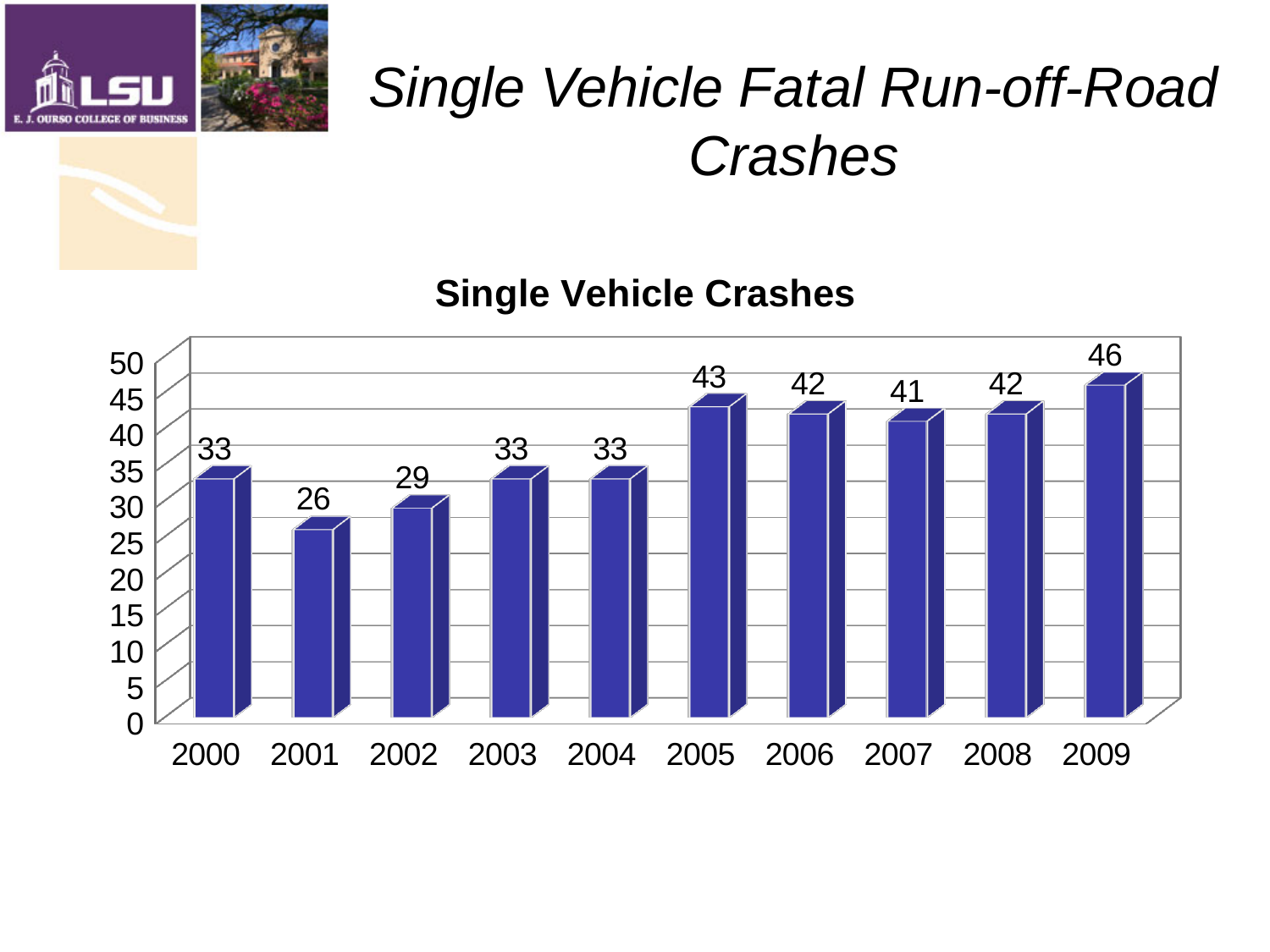
What is the difference between the values for 2009 and 2001? 20 Which is larger, the value for 2002 or the value for 2007? 2007 What is the title of the chart? Single Vehicle Crashes Which year has the lowest value? 2001 How many years are shown on the x axis? 10 What kind of chart is shown? bar chart What is the value for 2009? 46 Is the value for 2006 greater or less than 40? greater Which year has the highest value? 2009 What is the value for 2005? 43 What is the value for 2001? 26 What is the difference between the values for 2005 and 2004? 10